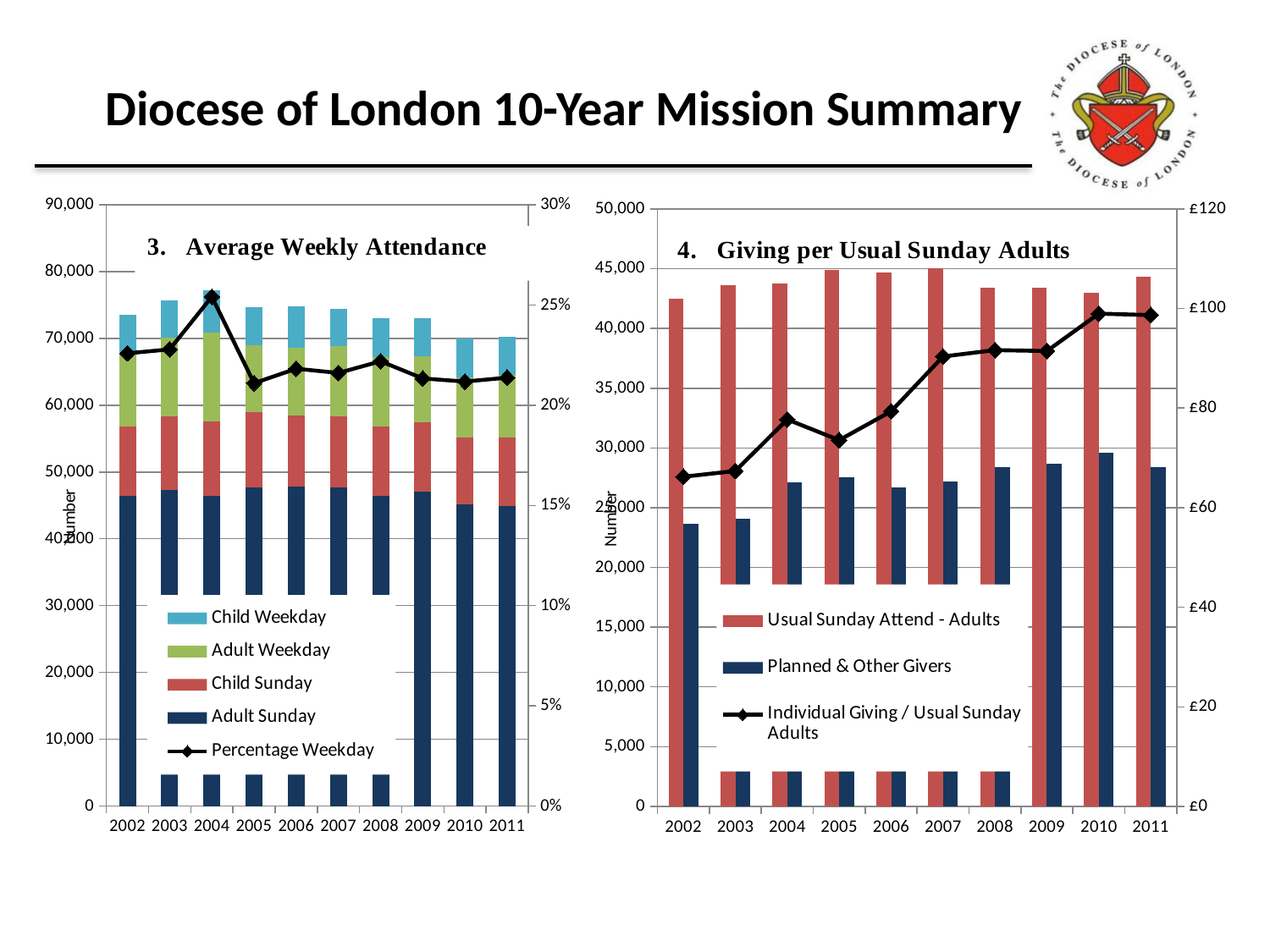
In the chart "3. Average Weekly Attendance", is the total stacked bar for 2002 greater or less than 70,000? greater In the chart "4. Giving per Usual Sunday Adults", which is larger: Planned & Other Givers in 2002 or in 2010? 2010 What type of chart is "3. Average Weekly Attendance"? Stacked bar chart with a line In the chart "4. Giving per Usual Sunday Adults", which year has the lowest Usual Sunday Attend - Adults bar? 2002 In the chart "3. Average Weekly Attendance", is the Percentage Weekday value for 2004 greater or less than 20%? greater In the chart "3. Average Weekly Attendance", how many years are shown on the x axis? 10 In the chart "4. Giving per Usual Sunday Adults", which year has the highest Planned & Other Givers bar? 2010 In the chart "4. Giving per Usual Sunday Adults", how many series does the legend list? 3 In the chart "4. Giving per Usual Sunday Adults", does the Individual Giving / Usual Sunday Adults line generally rise or fall from 2002 to 2011? rise In the chart "3. Average Weekly Attendance", how many series does the legend list? 5 In the chart "4. Giving per Usual Sunday Adults", is the Individual Giving / Usual Sunday Adults value for 2011 greater or less than £80? greater In the chart "3. Average Weekly Attendance", in which year is the Percentage Weekday line at its highest? 2004